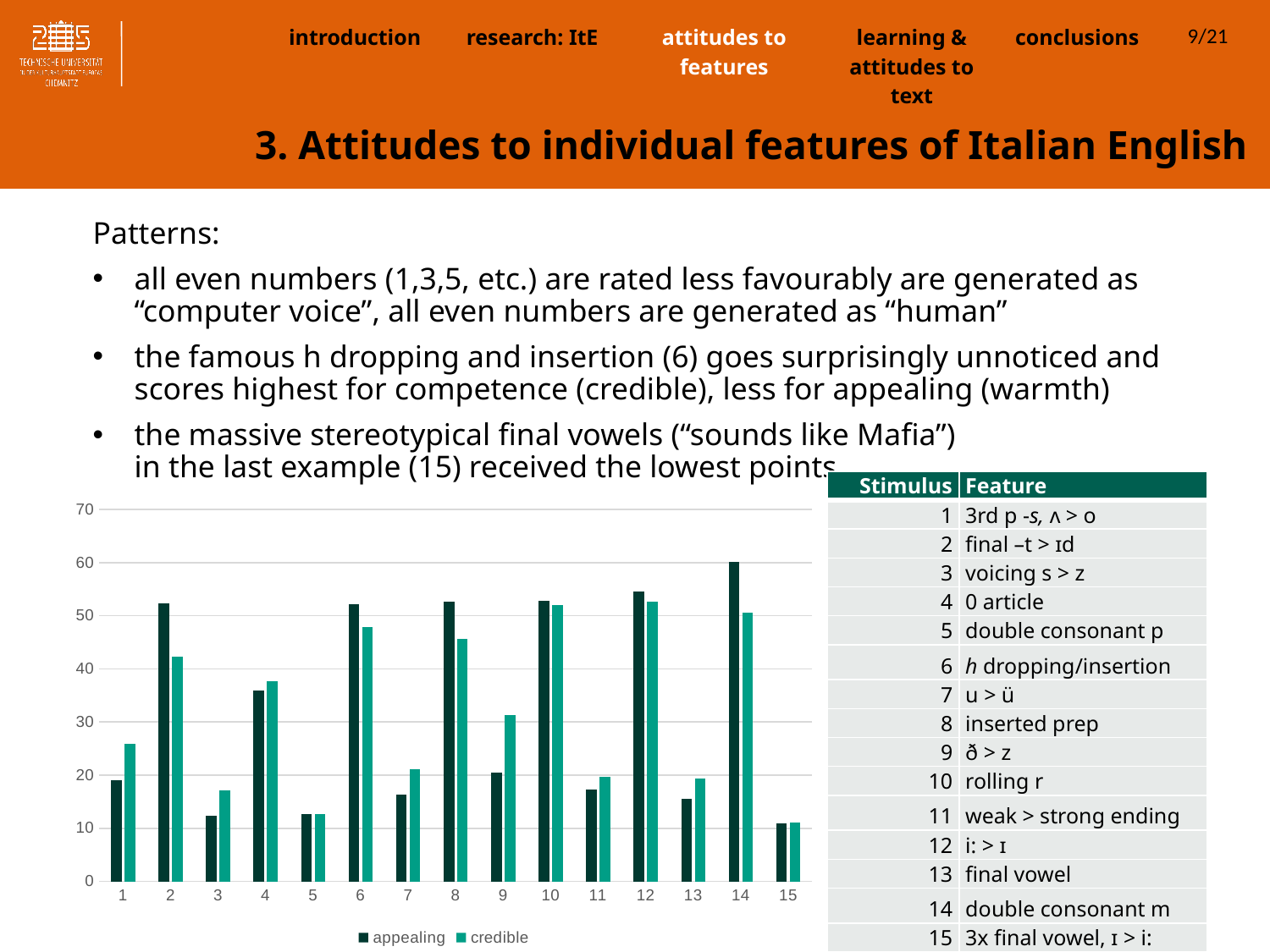
Is the 'credible' value for stimulus 14 greater or less than 40? greater Is the 'appealing' value for stimulus 4 greater or less than 30? greater What kind of chart is shown on the slide? bar chart For stimulus 14, which is larger: the 'appealing' value or the 'credible' value? appealing What are the two series named in the chart's legend? appealing and credible For stimulus 9, which is larger: the 'appealing' value or the 'credible' value? credible Is the 'appealing' value for stimulus 14 greater or less than 50? greater How many stimuli (categories) are plotted along the x axis of the chart? 15 How many series does the chart's legend list? 2 Which stimulus has the highest 'appealing' value in the chart? 14